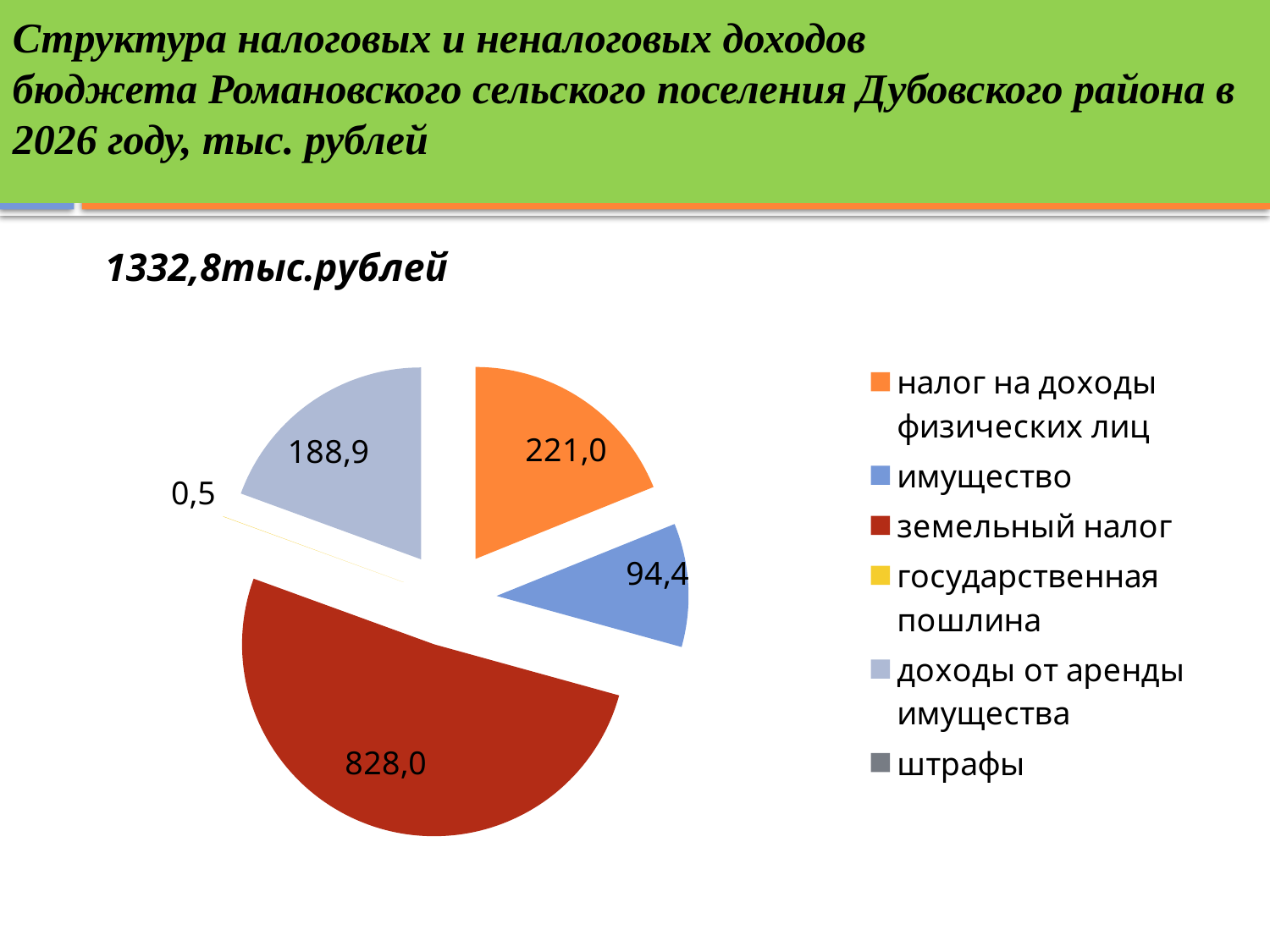
What is the value for доходы от аренды имущества? 188,9 What type of chart is shown on the slide? pie chart How many categories does the legend list? 6 Which category has the largest slice of the pie? земельный налог What is the value for налог на доходы физических лиц? 221,0 What is the difference between земельный налог and налог на доходы физических лиц? 607,0 What is the value for земельный налог? 828,0 What is the difference between доходы от аренды имущества and имущество? 94,5 What is the value for государственная пошлина? 0,5 What total amount is printed above the chart? 1332,8тыс.рублей What is the value for имущество? 94,4 Which of the two is larger: налог на доходы физических лиц or доходы от аренды имущества? налог на доходы физических лиц